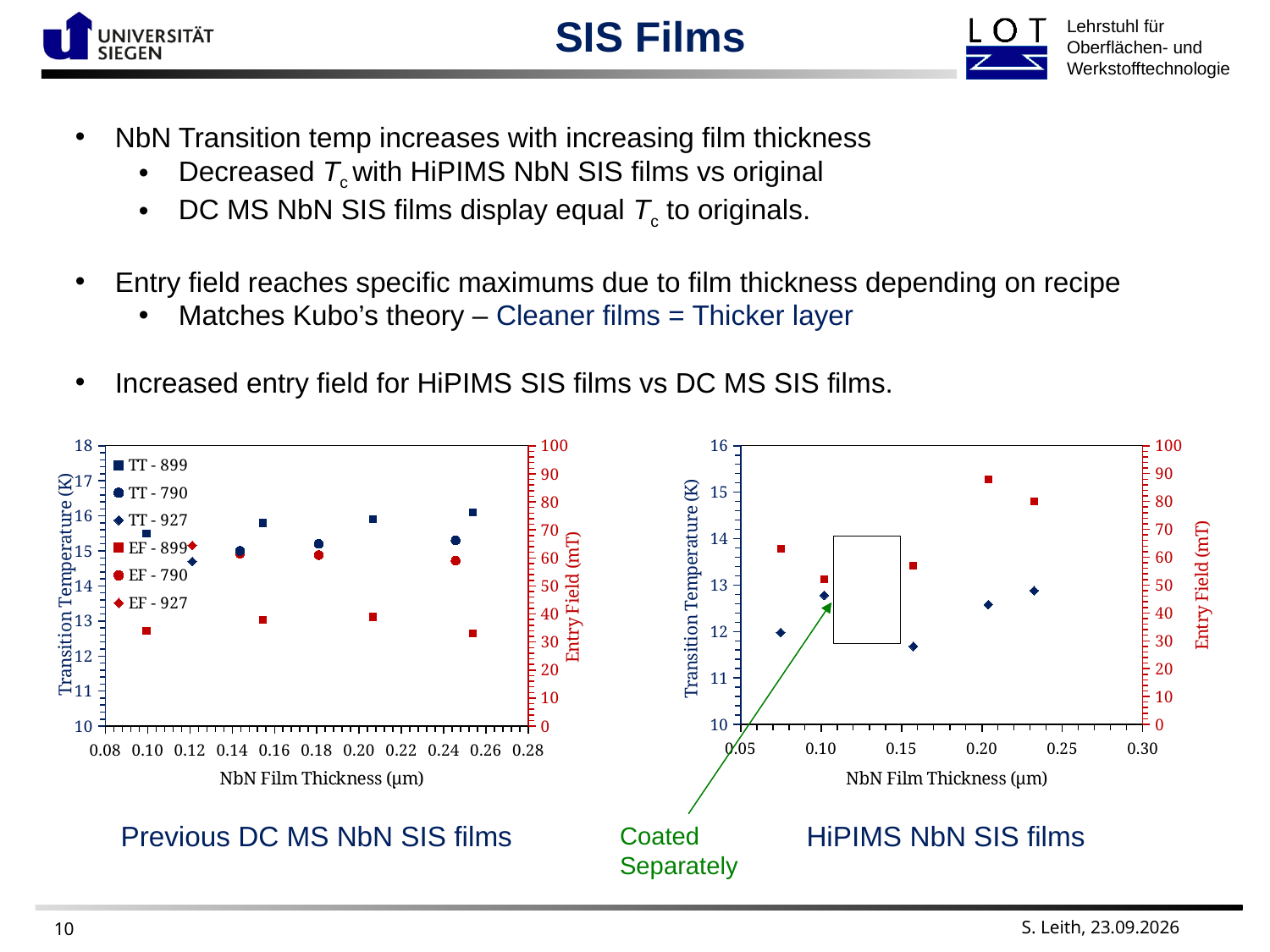
In the left chart ('Previous DC MS NbN SIS films'), is the TT - 899 value at about 0.255 µm film thickness greater or less than 15 K? greater In the left chart ('Previous DC MS NbN SIS films'), what is the label of the x axis? NbN Film Thickness (µm) How many series does the legend of the left chart ('Previous DC MS NbN SIS films') list? 6 In the right chart ('HiPIMS NbN SIS films'), how many blue diamond (transition temperature) points are plotted? 5 In the right chart ('HiPIMS NbN SIS films'), is the transition temperature at about 0.155 µm film thickness greater or less than 13 K? less In the right chart ('HiPIMS NbN SIS films'), is the entry field value at about 0.10 µm film thickness greater or less than 60 mT? less In the right chart ('HiPIMS NbN SIS films'), what is the label of the right-hand y axis? Entry Field (mT) What kind of chart is the 'Previous DC MS NbN SIS films' chart on the left? Scatter chart In the right chart ('HiPIMS NbN SIS films'), which entry field point is highest: the one at about 0.10 µm or the one at about 0.20 µm? 0.20 µm In the right chart ('HiPIMS NbN SIS films'), how many red square (entry field) points are plotted? 5